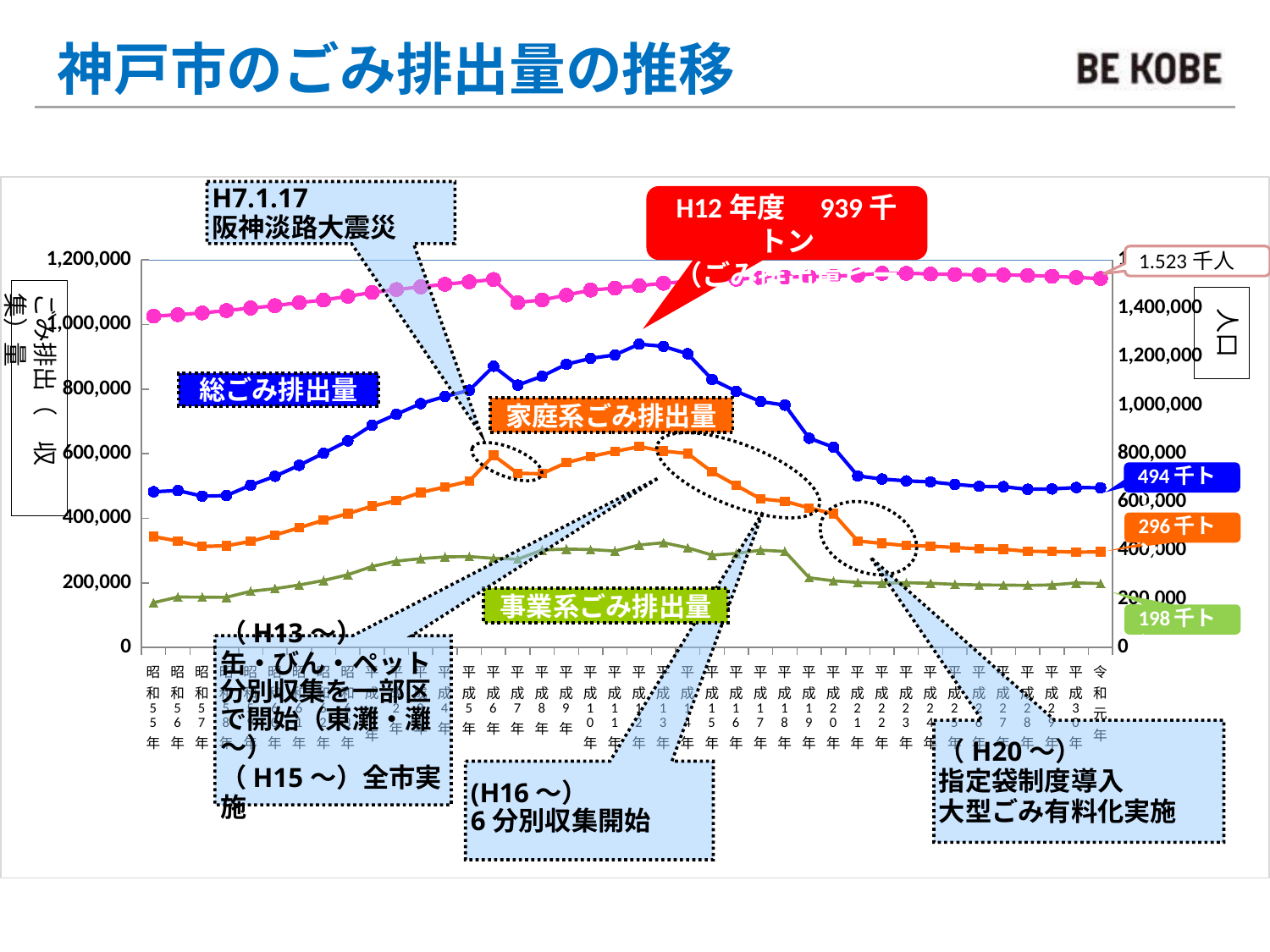
What is the difference between the final labelled values of 総ごみ排出量 (494千ト) and 家庭系ごみ排出量 (296千ト)? 198千トン What value is labelled at the end of the 事業系ごみ排出量 line? 198千ト Is the 事業系ごみ排出量 value at 昭和55年 greater or less than 200,000? less What is the title of the slide's chart? 神戸市のごみ排出量の推移 What population value is labelled at the end of the pink line? 1.523千人 What value is labelled at the end of the 家庭系ごみ排出量 line? 296千ト What peak value of total waste is called out for H12年度? 939千トン What value is labelled at the end of the 総ごみ排出量 line? 494千ト Does the 総ごみ排出量 line rise or fall after its H12 peak? fall Is the 総ごみ排出量 value at 昭和55年 greater or less than 400,000? greater At the end of the series, which is larger: 家庭系ごみ排出量 or 事業系ごみ排出量? 家庭系ごみ排出量 What kind of chart is shown on the slide? line chart